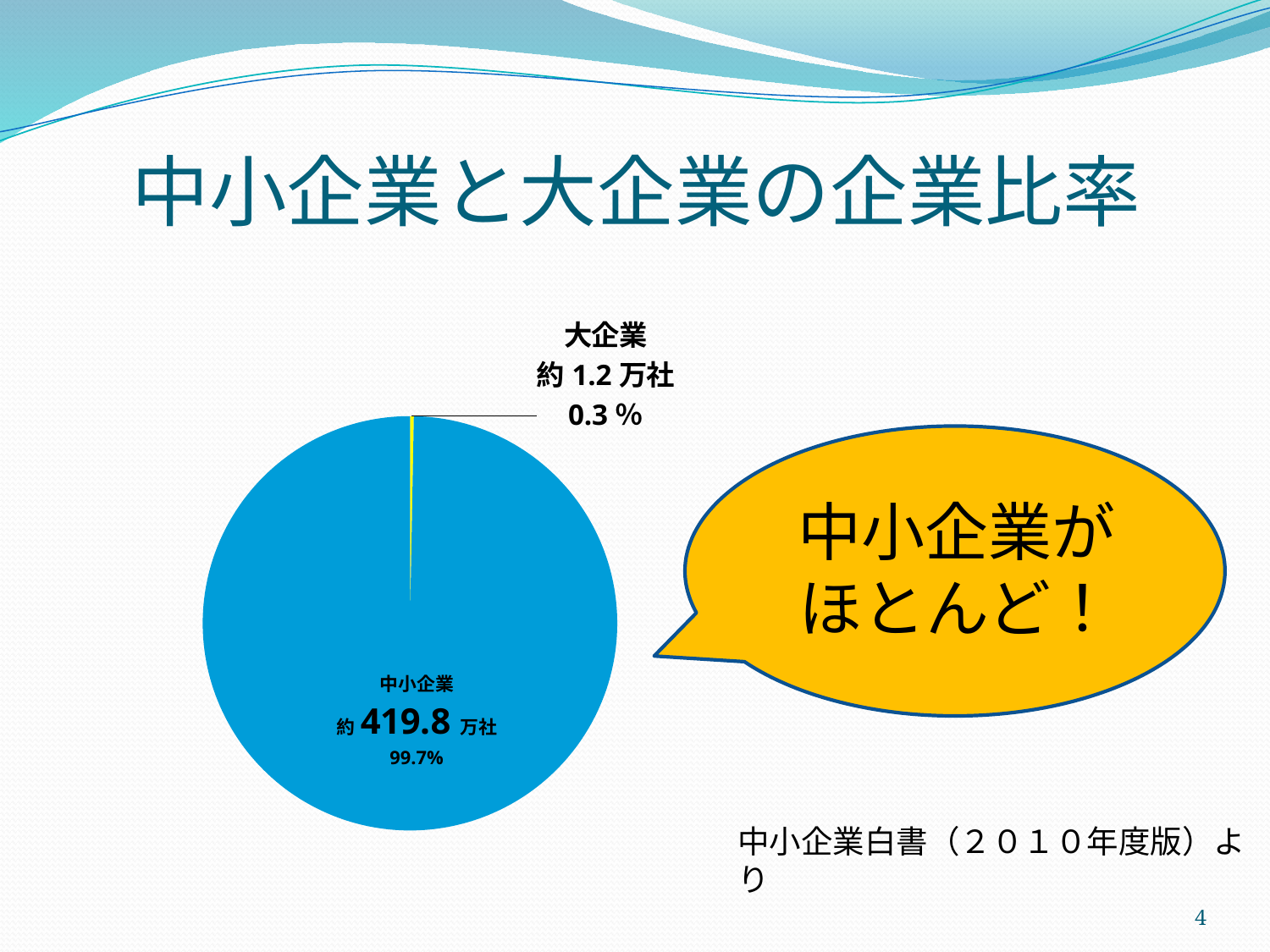
What kind of chart is shown on the slide? pie chart Which category has the largest slice of the pie? 中小企業 Which is larger, the number of 中小企業 or the number of 大企業? 中小企業 How many companies are shown for 中小企業? 約 419.8 万社 What share of the pie does 大企業 account for? 0.3 % How many companies are shown for 大企業? 約 1.2 万社 What share of the pie does 中小企業 account for? 99.7% What is the title of the slide containing the pie chart? 中小企業と大企業の企業比率 What is the difference in 万社 between 中小企業 and 大企業? 418.6 万社 Which category has the smallest slice of the pie? 大企業 What colour is the 中小企業 slice of the pie chart? blue How many slices does the pie chart have? 2